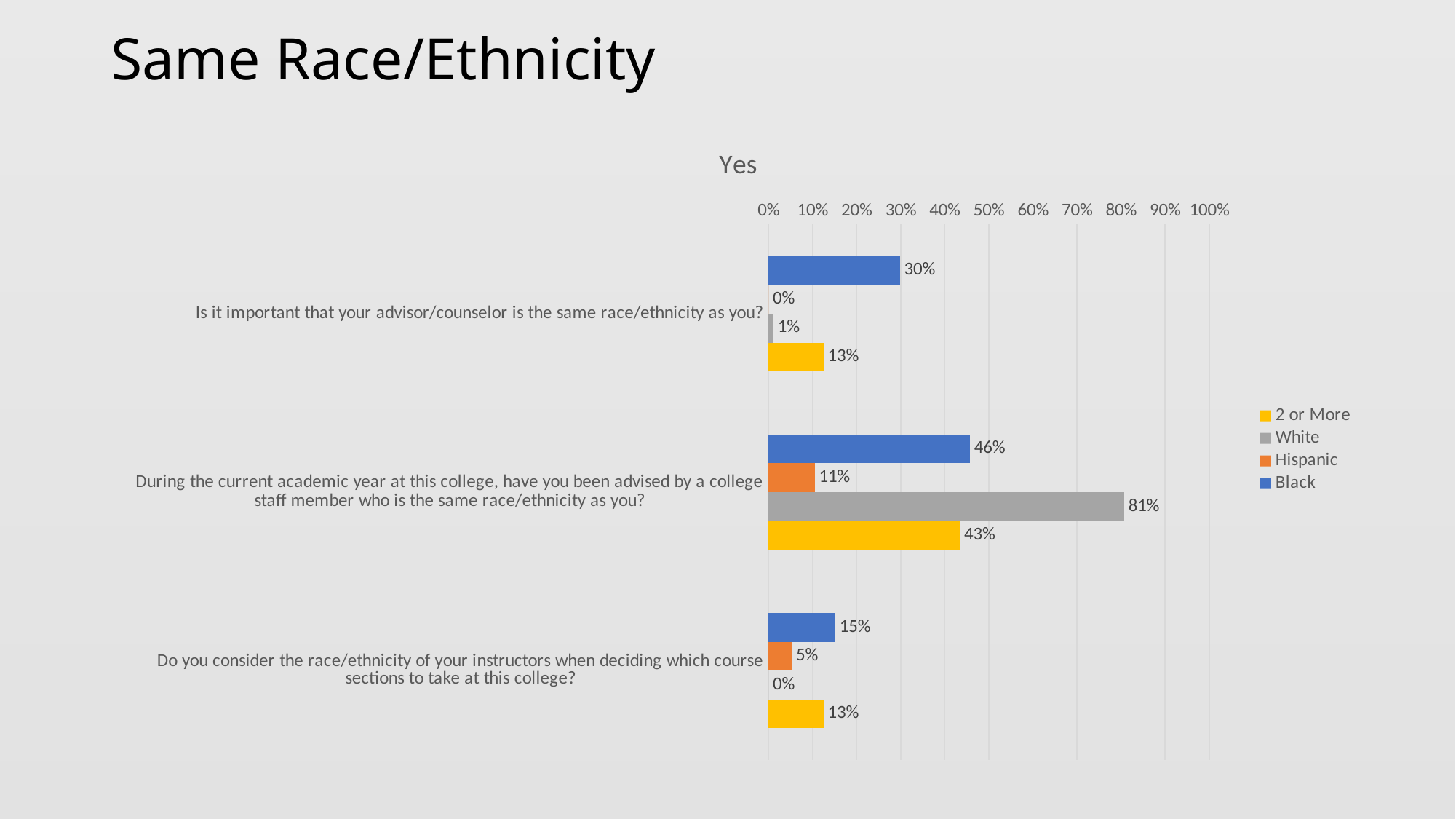
Which group has the highest value on the question about being advised by a college staff member of the same race/ethnicity? White What is the title of the chart? Yes How many series does the legend list? 4 How many survey questions (categories) are plotted on the chart? 3 What is the value for Black on the question about being advised by a college staff member of the same race/ethnicity? 46% Which group has the lowest value on the question about whether it is important that your advisor/counselor is the same race/ethnicity? Hispanic What kind of chart is shown on the slide? Bar chart What is the value for 2 or More on the question about whether it is important that your advisor/counselor is the same race/ethnicity? 13% What is the difference between the White and Black values on the question about being advised by a college staff member of the same race/ethnicity? 35% What is the value for Hispanic on the question about considering the race/ethnicity of instructors when choosing course sections? 5% What is the value for White on the question about being advised by a college staff member of the same race/ethnicity? 81% On the question about considering the race/ethnicity of instructors, which is larger: the value for Black or the value for 2 or More? Black